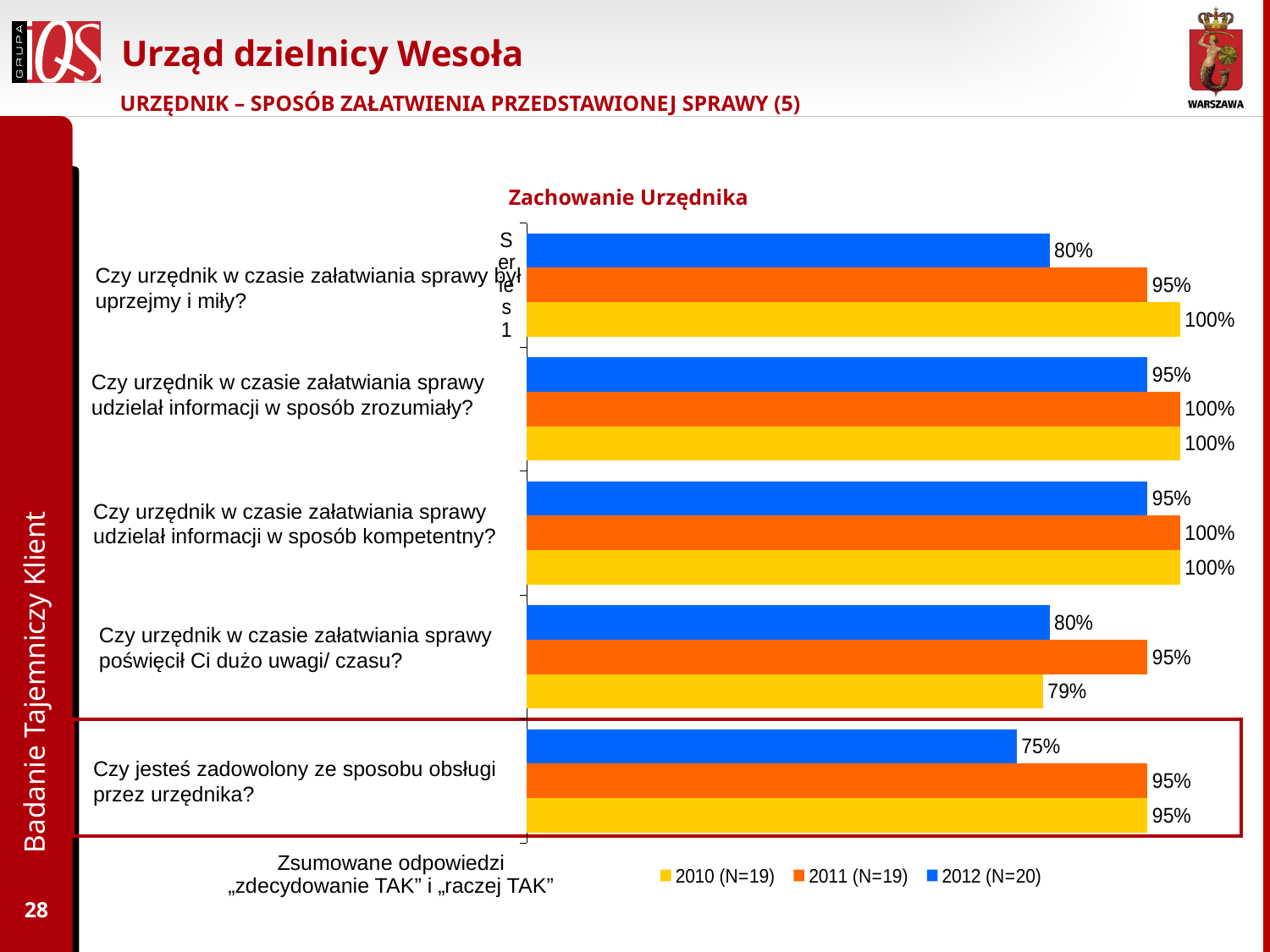
How many series does the legend list? 3 Which legend entry is shown in yellow? 2010 (N=19) What is the title of the chart? Zachowanie Urzędnika Which year has the lowest value for "Czy jesteś zadowolony ze sposobu obsługi przez urzędnika?"? 2012 (N=20) What is the 2010 (N=19) value for "Czy urzędnik w czasie załatwiania sprawy poświęcił Ci dużo uwagi/ czasu?"? 79% What is the 2012 (N=20) value for "Czy urzędnik w czasie załatwiania sprawy udzielał informacji w sposób kompetentny?"? 95% What is the difference between the 2010 (N=19) and 2012 (N=20) values for "Czy urzędnik w czasie załatwiania sprawy był uprzejmy i miły?"? 20% What is the 2012 (N=20) value for "Czy jesteś zadowolony ze sposobu obsługi przez urzędnika?"? 75% How many question categories are plotted on the chart? 5 What type of chart is shown on the slide? bar chart What is the 2011 (N=19) value for "Czy urzędnik w czasie załatwiania sprawy był uprzejmy i miły?"? 95% For "Czy urzędnik w czasie załatwiania sprawy poświęcił Ci dużo uwagi/ czasu?", which is larger: the 2011 (N=19) value or the 2010 (N=19) value? 2011 (N=19)